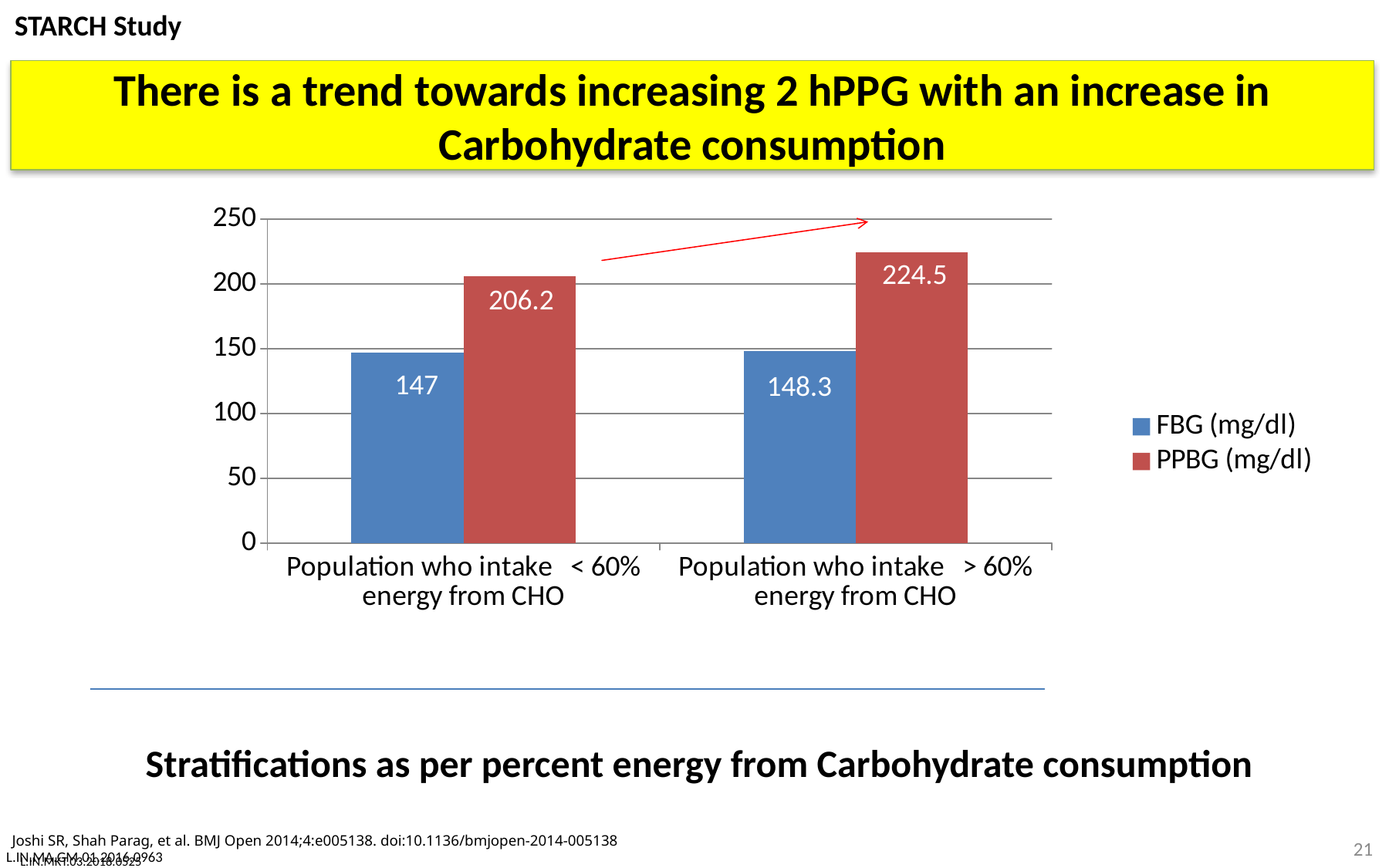
How many series does the legend list? 2 Is the PPBG (mg/dl) value for the population who intake > 60% energy from CHO greater or less than 200? greater What is the FBG (mg/dl) value for the population who intake > 60% energy from CHO? 148.3 What is the PPBG (mg/dl) value for the population who intake > 60% energy from CHO? 224.5 What is the PPBG (mg/dl) value for the population who intake < 60% energy from CHO? 206.2 What is the FBG (mg/dl) value for the population who intake < 60% energy from CHO? 147 How many population groups are shown on the x axis? 2 What is the difference between PPBG and FBG for the population who intake < 60% energy from CHO? 59.2 What is the difference in PPBG (mg/dl) between the > 60% and < 60% energy from CHO groups? 18.3 Which colour represents PPBG (mg/dl) in the chart? Red Which group has the higher PPBG (mg/dl) value? Population who intake > 60% energy from CHO What kind of chart is shown on the slide? Bar chart